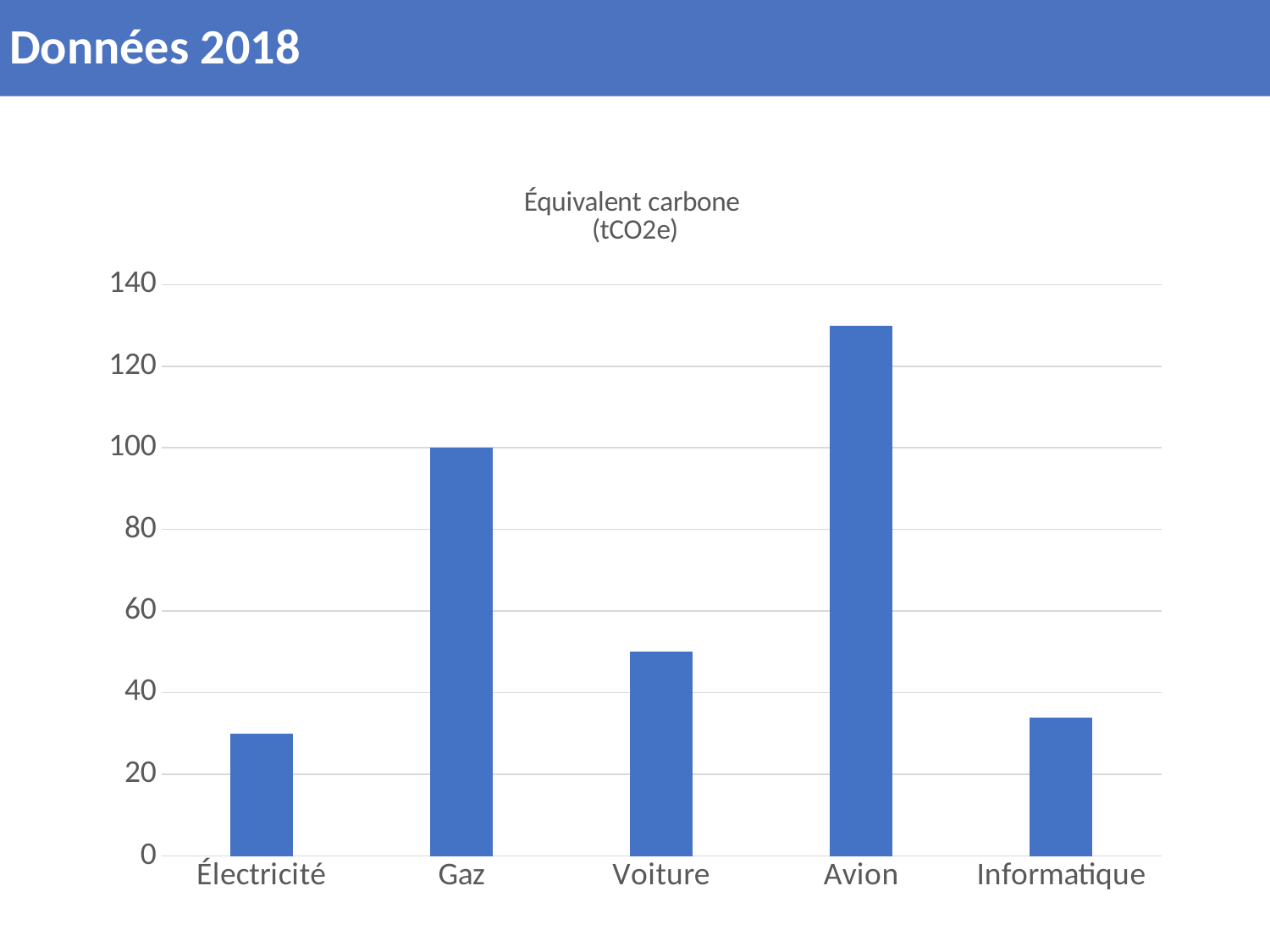
Is the value for Électricité greater or less than 40? less Which category has the lowest value? Électricité What kind of chart is shown on the slide? bar chart Which category has the highest value? Avion What is the title of the chart? Équivalent carbone (tCO2e) Which is larger, the value for Gaz or the value for Voiture? Gaz What is the value for Gaz? 100 Is the value for Avion greater or less than 120? greater Which is larger, the value for Avion or the value for Gaz? Avion Is the value for Informatique greater or less than 40? less How many categories are shown on the x axis? 5